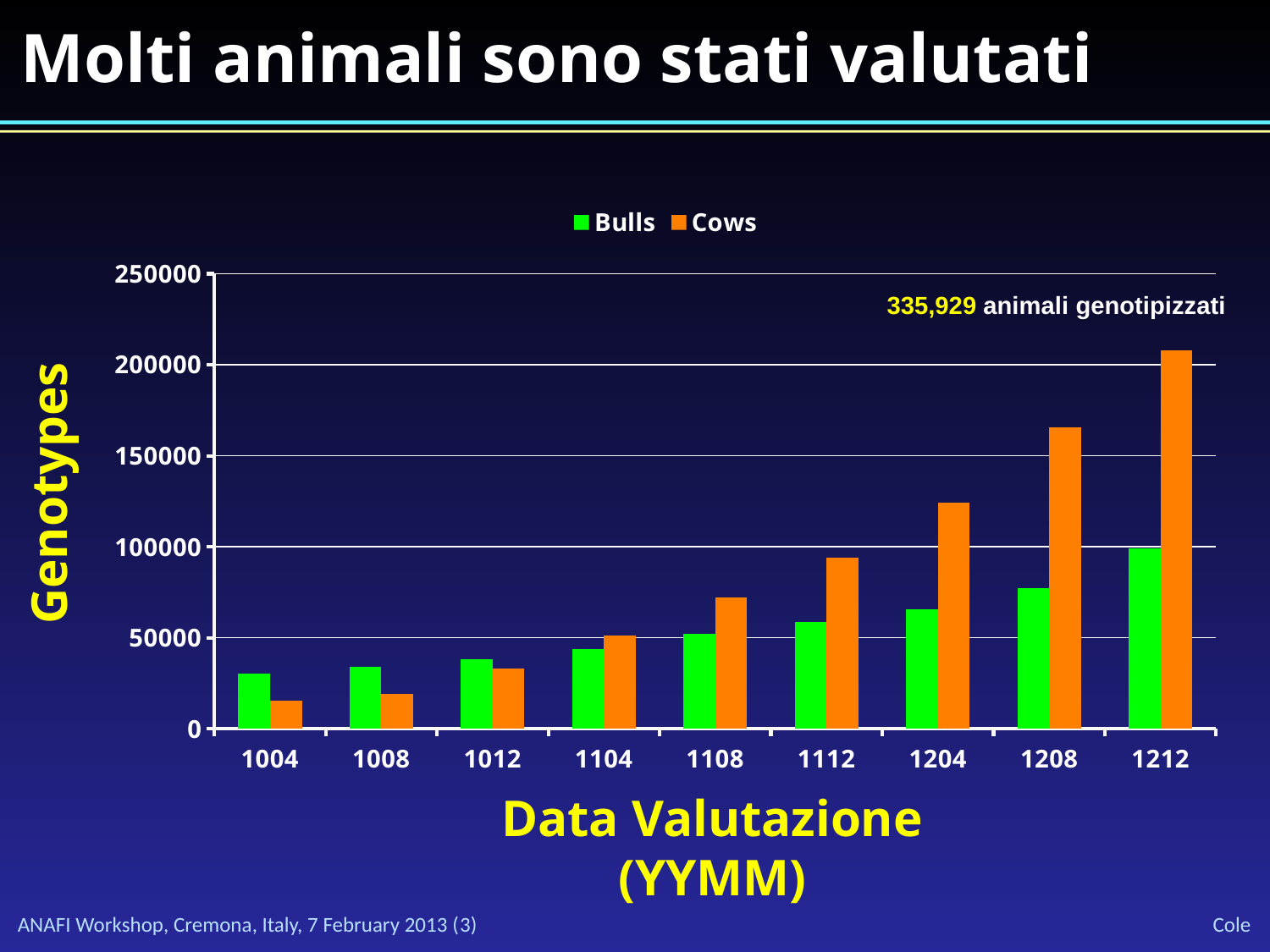
Is the Cows value for 1212 greater or less than 200000? greater How many evaluation dates are shown on the x axis? 9 How many genotyped animals does the annotation on the chart report? 335,929 Is the Bulls value for 1204 greater or less than 50000? greater What kind of chart is shown on the slide? bar chart At evaluation date 1212, which is larger, Bulls or Cows? Cows At which evaluation date is the Cows bar highest? 1212 At which evaluation date is the Bulls bar lowest? 1004 At evaluation date 1004, which is larger, Bulls or Cows? Bulls Is the Cows value for 1004 greater or less than 50000? less Do the Cows values rise or fall from 1004 to 1212? rise How many series does the legend list? 2